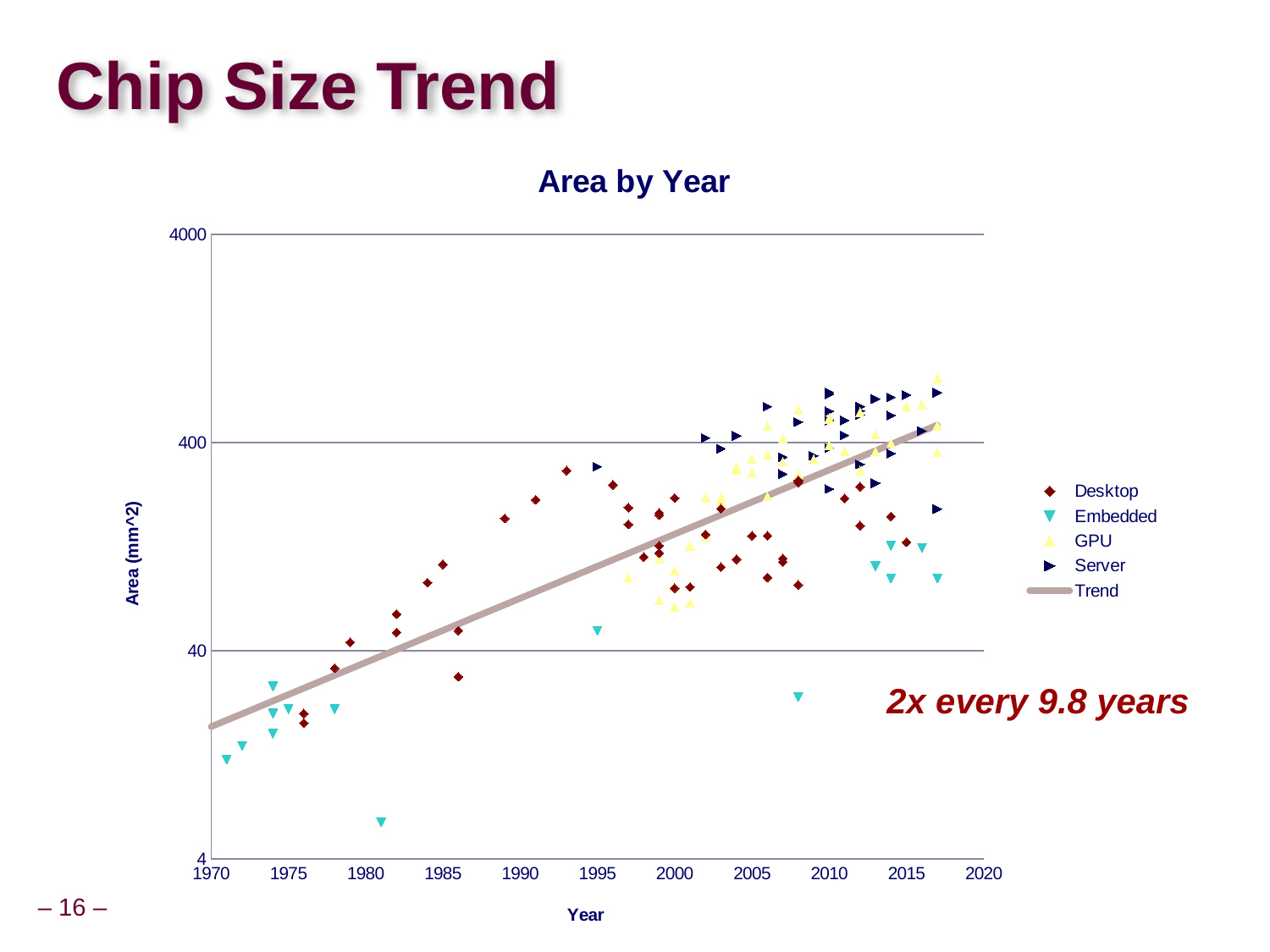
Which is larger: the Server point at 2010 or the Embedded point at 2008? Server point at 2010 Is the value for the Desktop point at 1993 greater or less than 400? less Is the value for the Embedded point at 1981 greater or less than 40? less Which series has the lowest plotted point on the chart? Embedded What is the title of the chart? Area by Year Does the Trend line rise or fall as the year increases? rises What type of chart is shown on the slide? scatter chart Is the value for the highest Server point at 2010 greater or less than 400? greater What is the label of the y axis? Area (mm^2) How many series does the chart's legend list? 5